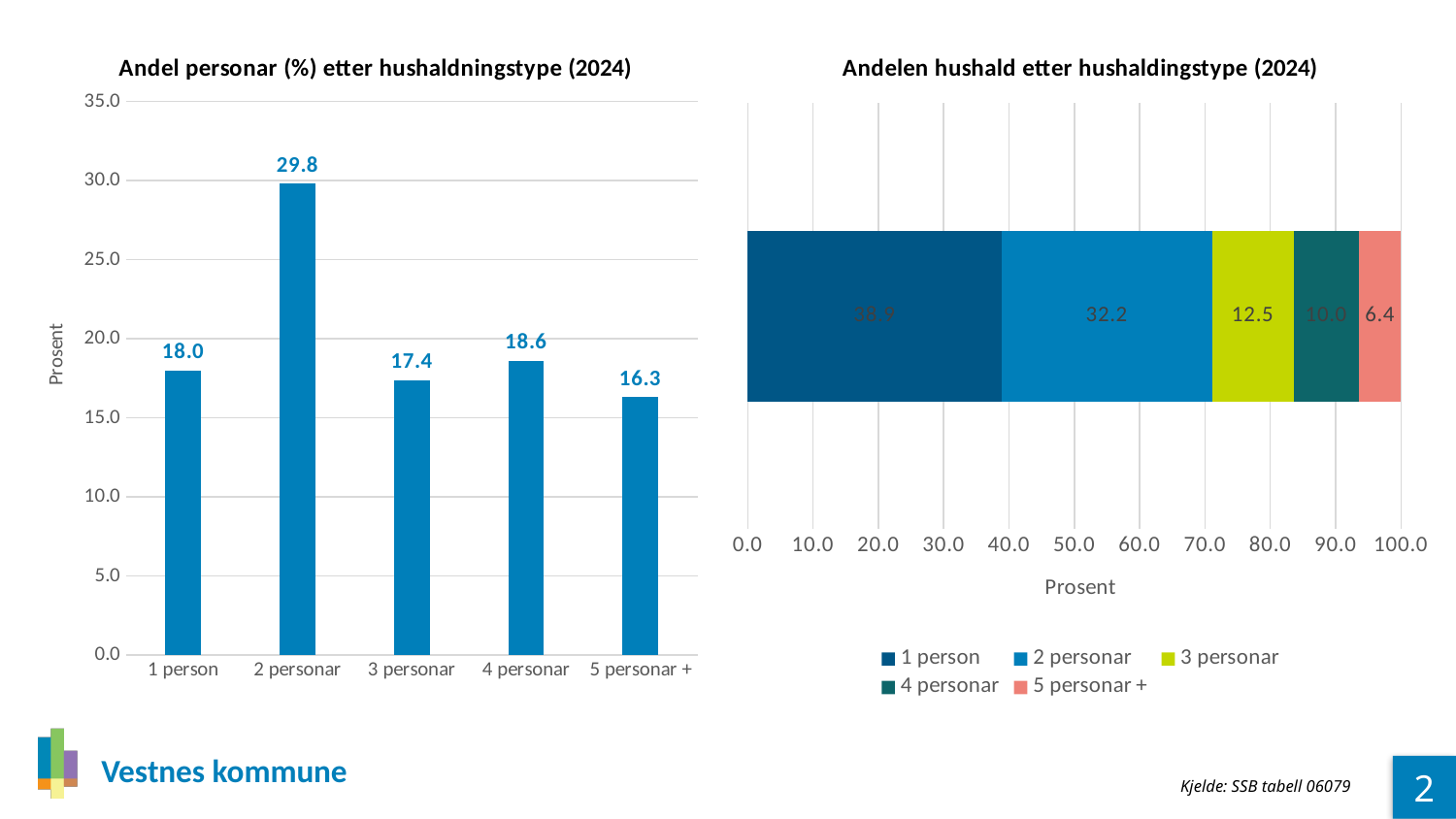
How many categories are shown on the x axis of the chart 'Andel personar (%) etter hushaldningstype (2024)'? 5 In the chart 'Andelen hushald etter hushaldingstype (2024)', what is the value for 2 personar? 32.2 What kind of chart is 'Andel personar (%) etter hushaldningstype (2024)'? Bar chart In the chart 'Andel personar (%) etter hushaldningstype (2024)', what is the difference between the values for 2 personar and 1 person? 11.8 In the chart 'Andelen hushald etter hushaldingstype (2024)', what is the value for 3 personar? 12.5 In the chart 'Andel personar (%) etter hushaldningstype (2024)', which household type has the highest value? 2 personar In the chart 'Andel personar (%) etter hushaldningstype (2024)', what is the value for 2 personar? 29.8 In the chart 'Andelen hushald etter hushaldingstype (2024)', what is the difference between the values for 3 personar and 5 personar +? 6.1 In the chart 'Andel personar (%) etter hushaldningstype (2024)', what is the value for 5 personar +? 16.3 In the chart 'Andel personar (%) etter hushaldningstype (2024)', which is larger: the value for 4 personar or the value for 3 personar? 4 personar In the chart 'Andel personar (%) etter hushaldningstype (2024)', which household type has the lowest value? 5 personar + How many series does the legend of the chart 'Andelen hushald etter hushaldingstype (2024)' list? 5